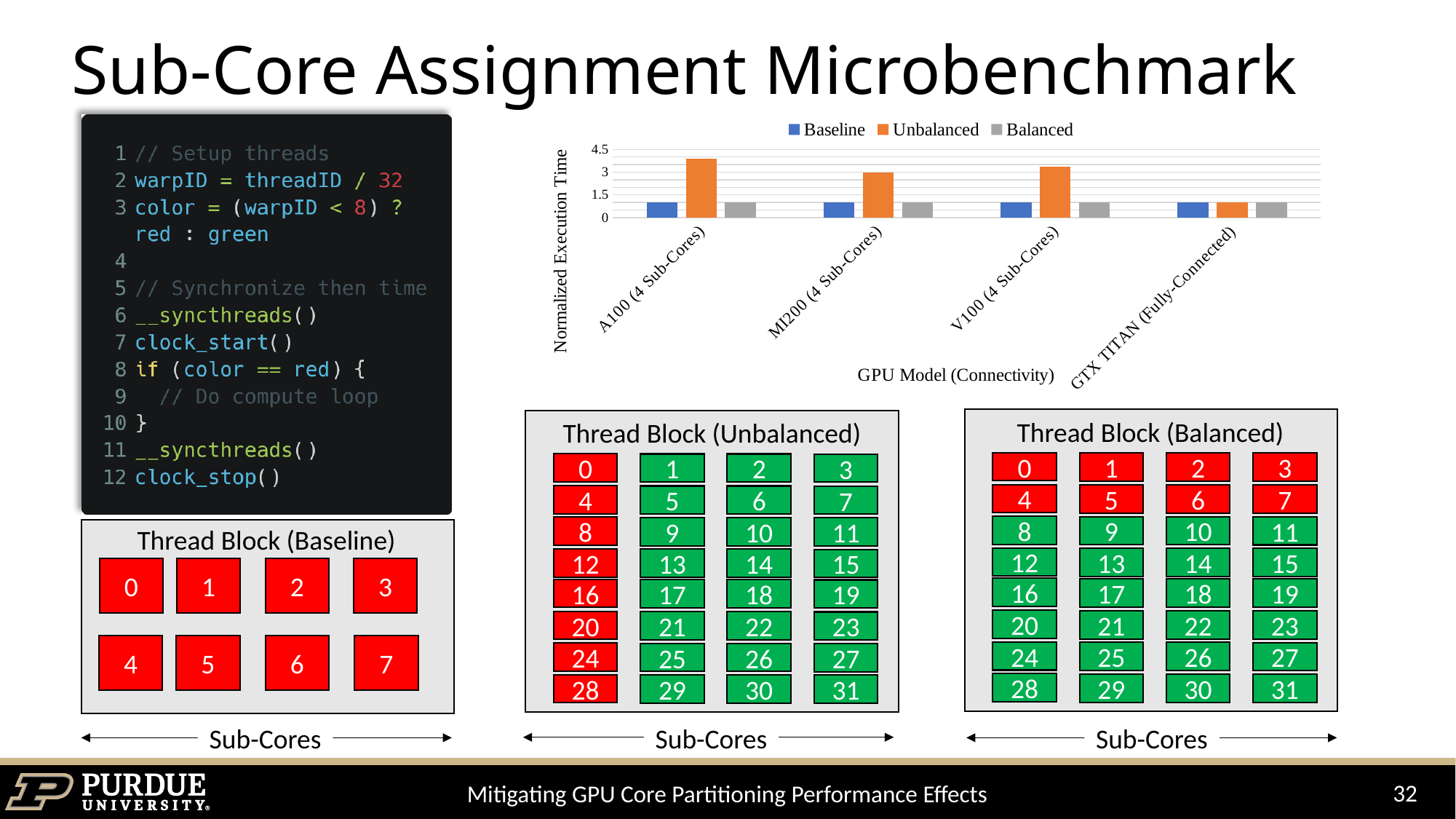
Is the Unbalanced value for GTX TITAN (Fully-Connected) greater or less than 1.5? less Which colour represents the Unbalanced series in the chart? orange Is the Unbalanced value for V100 (4 Sub-Cores) greater or less than 3? greater How many GPU models are shown along the x axis of the chart? 4 Is the Unbalanced value for A100 (4 Sub-Cores) greater or less than 3? greater Which GPU model has the highest Unbalanced bar? A100 (4 Sub-Cores) Which is larger: the Unbalanced bar for A100 (4 Sub-Cores) or the Unbalanced bar for V100 (4 Sub-Cores)? A100 (4 Sub-Cores) Which is larger for A100 (4 Sub-Cores): the Unbalanced bar or the Baseline bar? Unbalanced What is the title of the chart's y axis? Normalized Execution Time What kind of chart is shown on the slide? bar chart Which GPU model has the lowest Unbalanced bar? GTX TITAN (Fully-Connected) How many series does the chart's legend list? 3